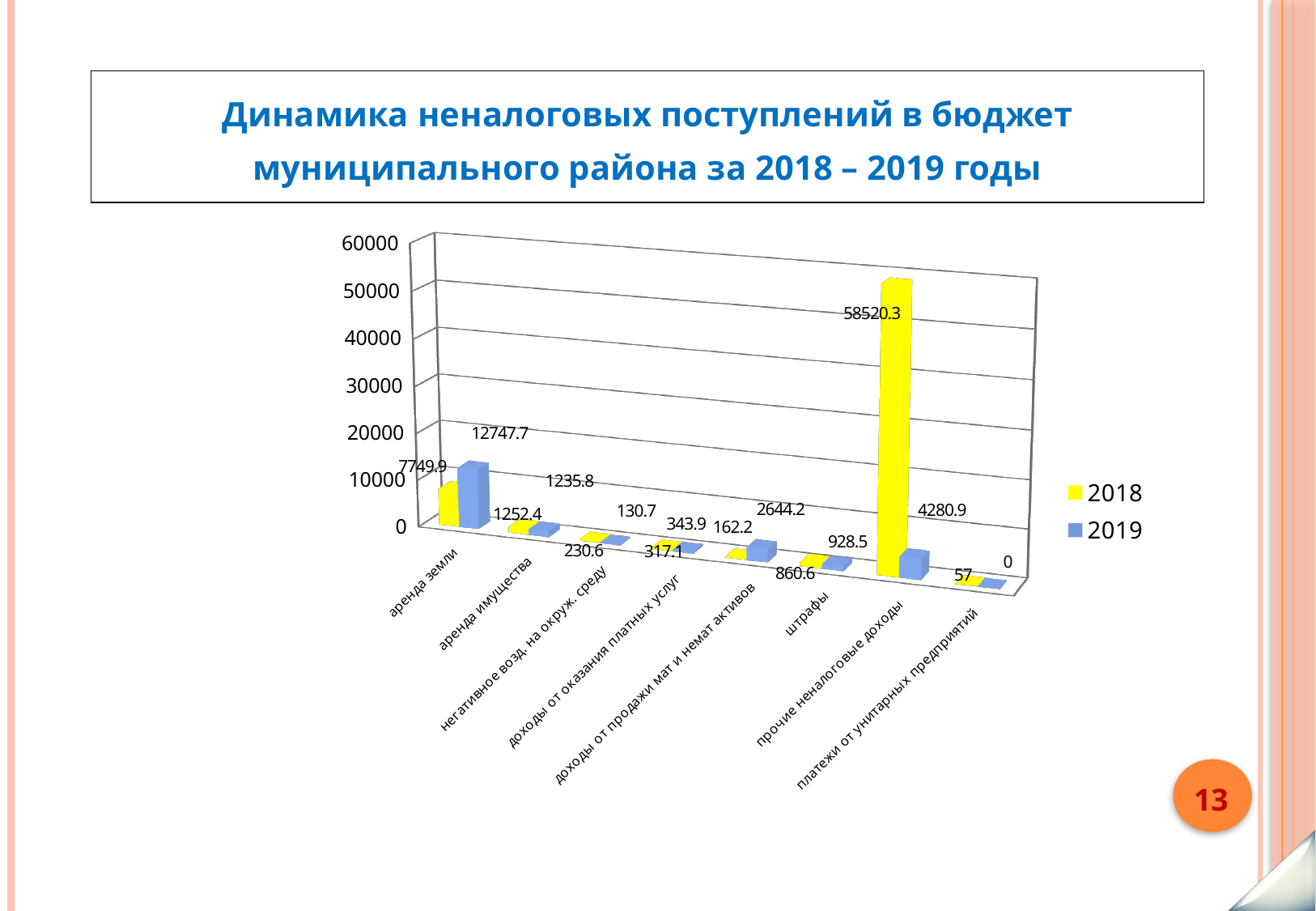
What is the 2018 value for аренда земли? 7749.9 Which category has the lowest 2019 value? платежи от унитарных предприятий How many series does the legend list? 2 What is the difference between the 2018 and 2019 values for прочие неналоговые доходы? 54239.4 What kind of chart is shown on the slide? bar chart Which category has the highest 2018 value? прочие неналоговые доходы What is the 2019 value for прочие неналоговые доходы? 4280.9 Which colour represents the 2019 series? blue What is the 2019 value for аренда земли? 12747.7 Which is larger for доходы от продажи мат и немат активов: the 2018 value or the 2019 value? 2019 How many categories are shown on the x axis? 8 What is the 2018 value for штрафы? 860.6